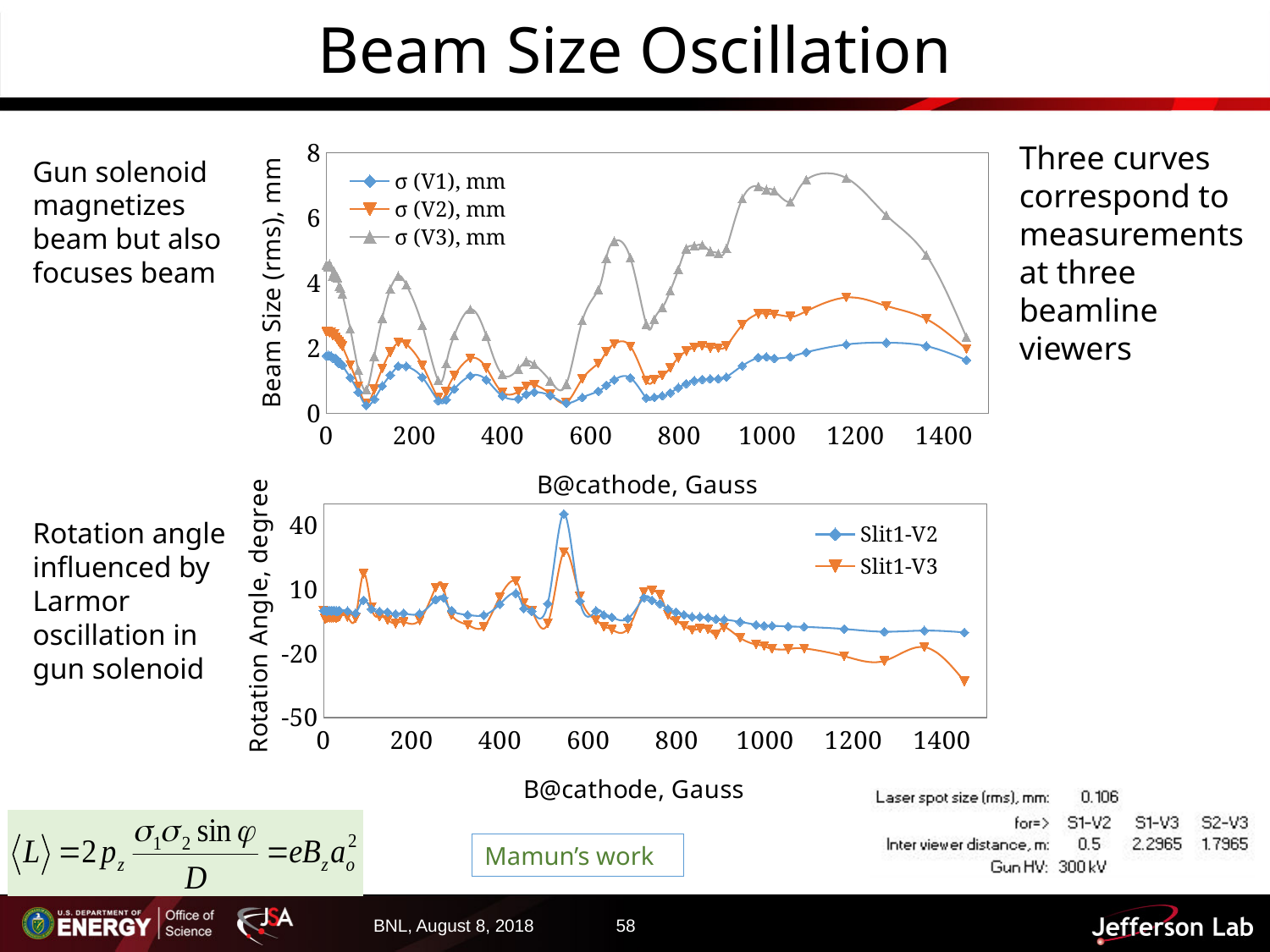
In the top chart (Beam Size), which series stays lowest across the range? σ (V1), mm In the bottom chart (Rotation Angle), is the value of Slit1-V3 at about 1450 Gauss greater or less than -20? less In the top chart (Beam Size), is the value of σ (V3) at 0 Gauss greater or less than 4? greater How many series does the legend of the bottom chart (Rotation Angle) list? 2 In the bottom chart (Rotation Angle), does the Slit1-V3 series generally rise or fall between 800 and 1400 Gauss? fall What kind of chart is the top chart (Beam Size)? line chart In the top chart (Beam Size), which series reaches the highest beam size? σ (V3), mm In the top chart (Beam Size), is the peak value of σ (V3) near 1150 Gauss greater or less than 6? greater How many series does the legend of the top chart (Beam Size) list? 3 What is the x-axis label of the bottom chart (Rotation Angle)? B@cathode, Gauss